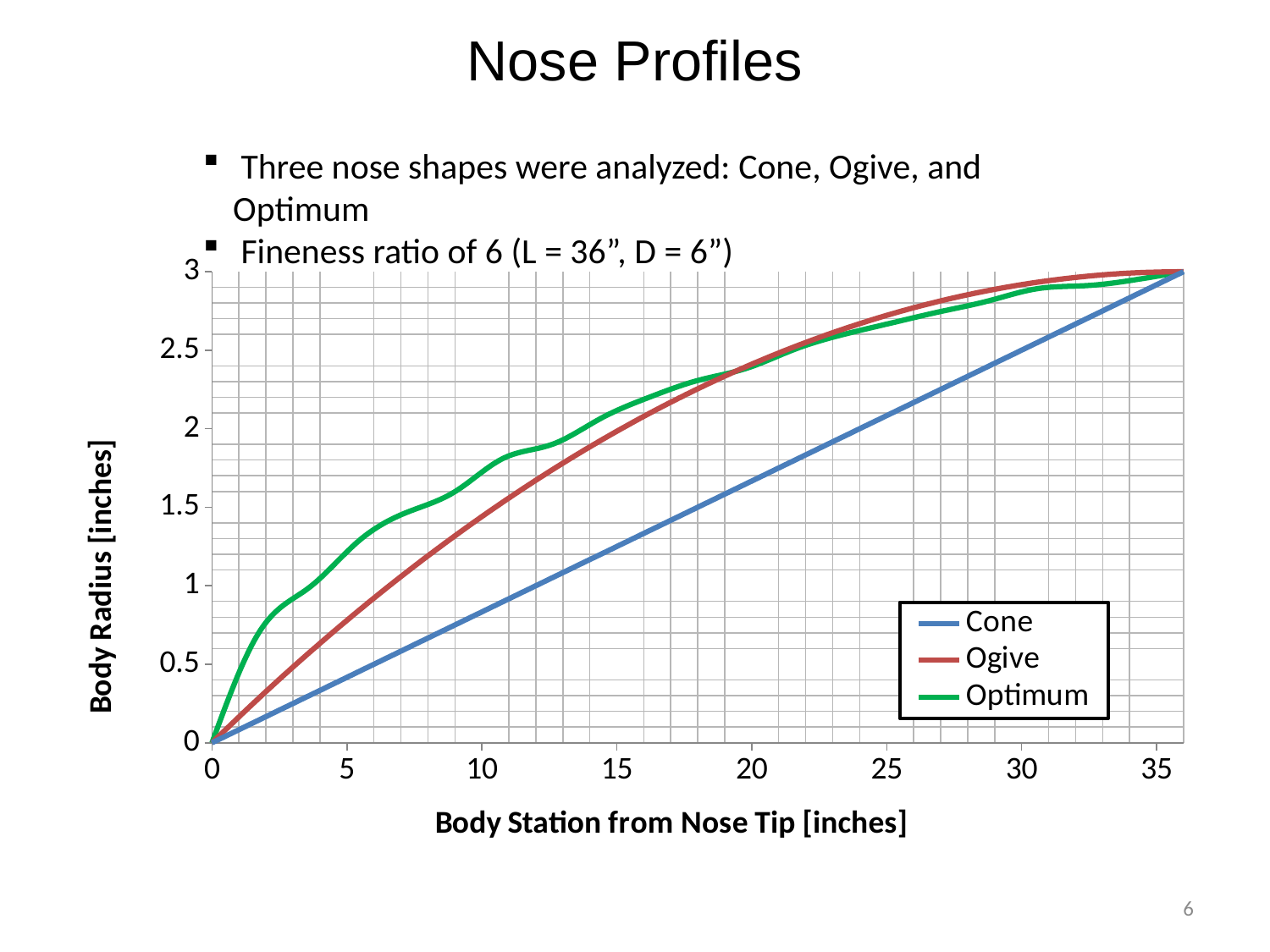
What kind of chart is shown on the slide? line chart What is the title of the x axis? Body Station from Nose Tip [inches] Does the Cone series rise or fall as body station increases? rise At body station 15, which series has the larger body radius, Ogive or Cone? Ogive What is the body radius of all three series at body station 0? 0 How many series does the legend list? 3 Is the value for Cone at body station 10 greater or less than 1? less Is the value for Ogive at body station 5 greater or less than 1? less Is the value for Cone at body station 20 greater or less than 1.5? greater At body station 5, which series has the larger body radius, Optimum or Cone? Optimum Which series are listed in the legend? Cone, Ogive, Optimum